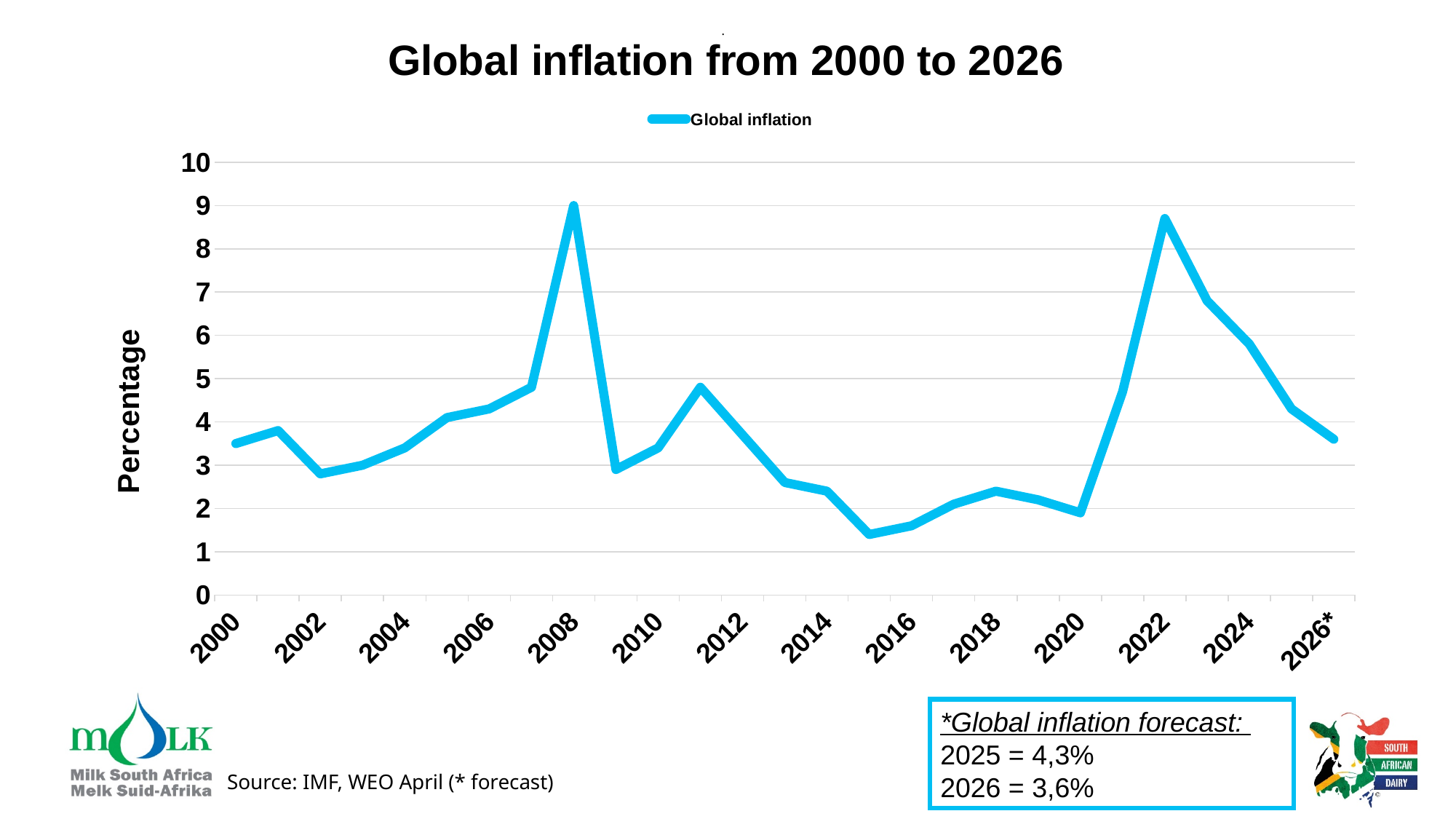
Is the global inflation value for 2024 greater or less than 5? greater What is the title of the y axis? Percentage What is the forecast global inflation value for 2026 shown on the slide? 3,6% By how much is the 2025 forecast higher than the 2026 forecast? 0,7% Which year has the larger global inflation value, 2008 or 2015? 2008 What is the forecast global inflation value for 2025 shown on the slide? 4,3% Is the global inflation value for 2008 greater or less than 8? greater Does global inflation rise or fall from 2022 to 2026? fall What kind of chart is shown on the slide? line chart How many series does the legend list? 1 Is the global inflation value for 2015 greater or less than 2? less Which year has the lowest global inflation value on the chart? 2015